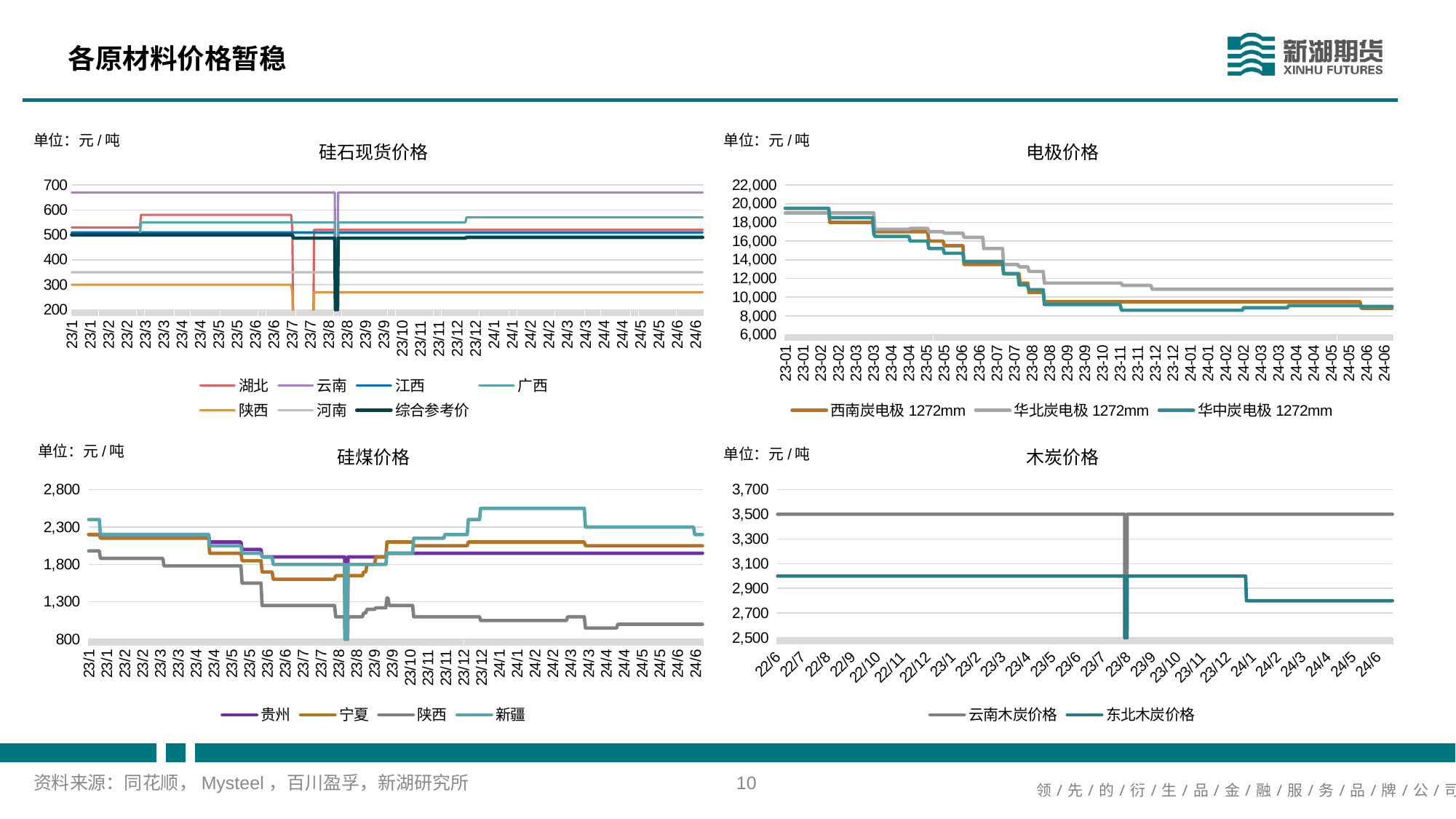
In the 硅煤价格 chart, which series has the lowest value at 24/6? 陕西 In the 电极价格 chart, is the value for 华北炭电极 1272mm at 24-06 greater or less than 10,000? greater In the 硅石现货价格 chart, is the value for 云南 greater or less than 600? greater What kind of chart is the 硅石现货价格 chart? line chart In the 硅煤价格 chart, is the value for 陕西 at 24/6 greater or less than 1,300? less In the 木炭价格 chart, what is the value for 云南木炭价格? 3,500 In the 硅石现货价格 chart, which series has the lowest values? 陕西 In the 硅石现货价格 chart, which series has the highest values? 云南 In the 电极价格 chart, do the values rise or fall from 23-01 to 24-06? fall How many series does the legend of the 硅石现货价格 chart list? 7 What unit is shown for the 木炭价格 chart? 元/吨 How many series does the legend of the 电极价格 chart list? 3